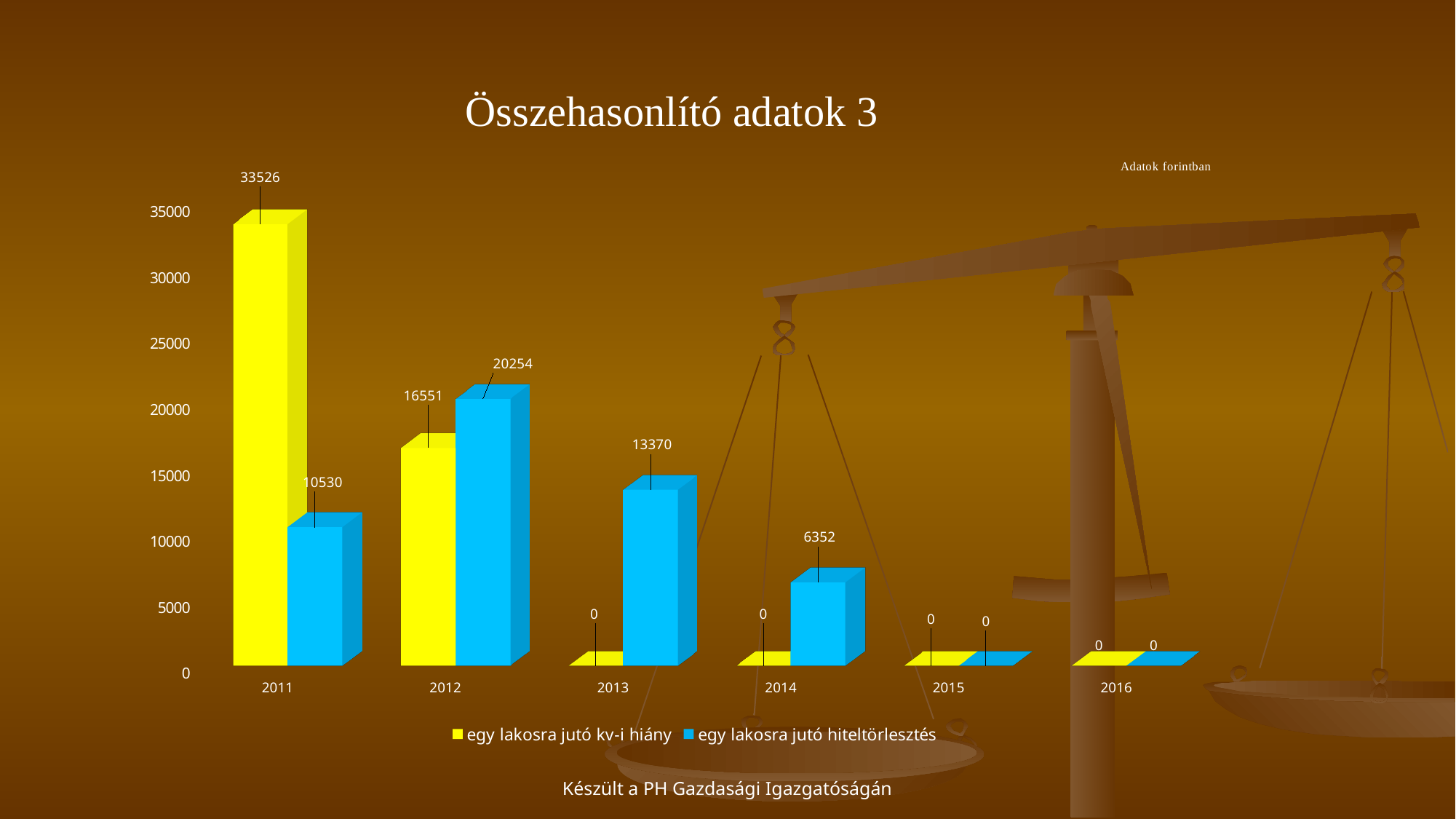
What is the value of 'egy lakosra jutó kv-i hiány' for 2011? 33526 In 2012, which is larger: 'egy lakosra jutó kv-i hiány' or 'egy lakosra jutó hiteltörlesztés'? egy lakosra jutó hiteltörlesztés How many years are shown on the x axis? 6 What is the value of 'egy lakosra jutó kv-i hiány' for 2013? 0 What is the difference between 'egy lakosra jutó kv-i hiány' and 'egy lakosra jutó hiteltörlesztés' in 2011? 22996 What is the value of 'egy lakosra jutó hiteltörlesztés' for 2012? 20254 What is the value of 'egy lakosra jutó hiteltörlesztés' for 2014? 6352 Which year has the highest value for 'egy lakosra jutó hiteltörlesztés'? 2012 Does 'egy lakosra jutó hiteltörlesztés' rise or fall from 2012 to 2015? fall What colour represents 'egy lakosra jutó kv-i hiány' in the chart? yellow What kind of chart is shown on the slide? bar chart How many series does the legend list? 2